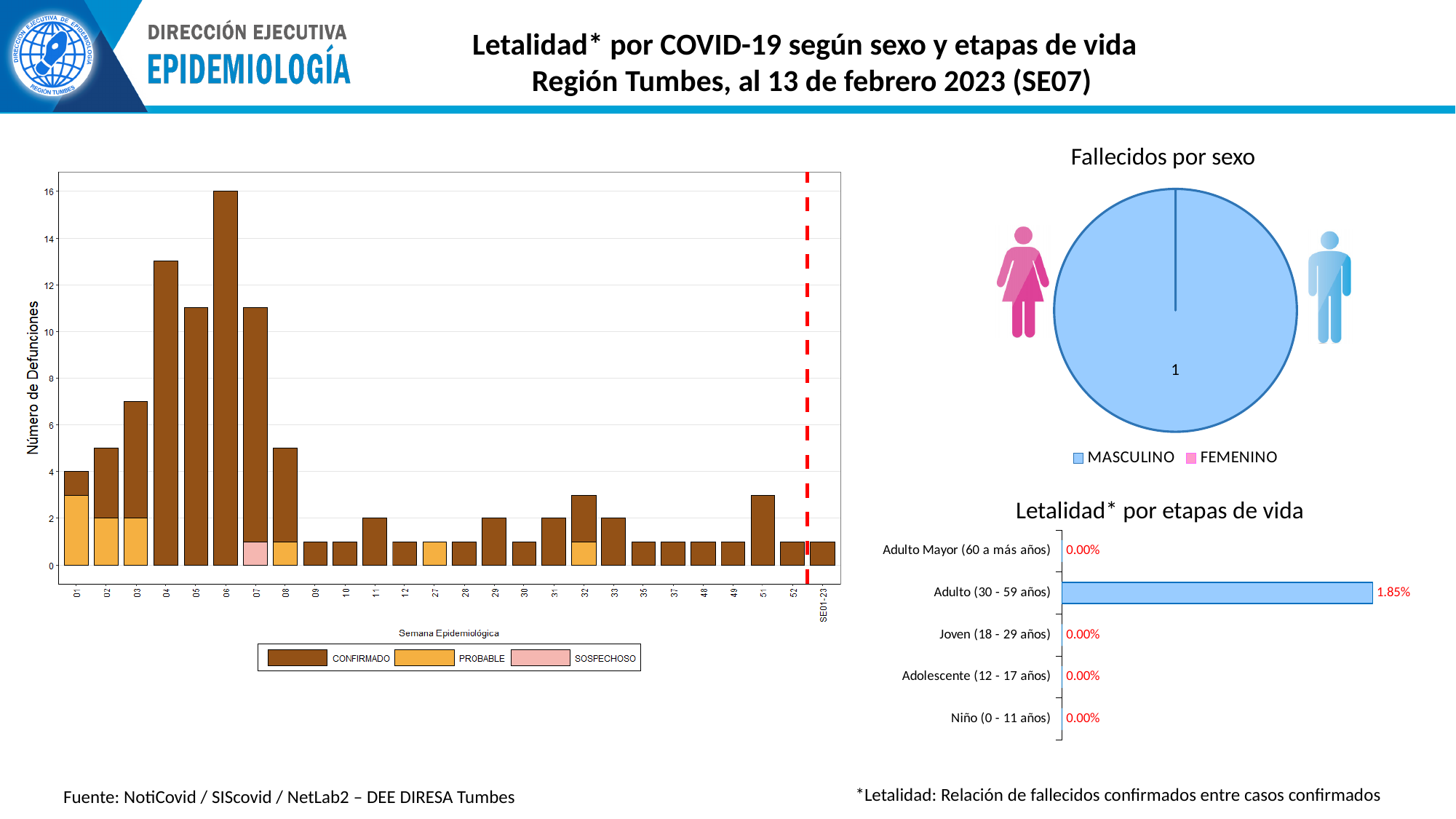
In the 'Letalidad* por etapas de vida' chart, which age group has the highest value? Adulto (30 - 59 años) How many series does the legend of the weekly 'Número de Defunciones' chart on the left list? 3 How many entries does the legend of the 'Fallecidos por sexo' pie chart list? 2 In the weekly 'Número de Defunciones' chart on the left, what is the total height of the bar for week 06? 16 In the 'Fallecidos por sexo' pie chart, which category does the only visible slice belong to? MASCULINO In the 'Letalidad* por etapas de vida' chart, what is the value for Adulto Mayor (60 a más años)? 0.00% In the 'Letalidad* por etapas de vida' chart, how many age groups are shown? 5 In the 'Fallecidos por sexo' pie chart, what value is printed on the slice? 1 In the weekly 'Número de Defunciones' chart on the left, which epidemiological week has the highest bar? 06 In the weekly 'Número de Defunciones' chart on the left, is the value for week 04 greater or less than 12? greater In the 'Letalidad* por etapas de vida' chart, what is the difference between the values for Adulto (30 - 59 años) and Joven (18 - 29 años)? 1.85% In the 'Letalidad* por etapas de vida' chart, what is the value for Adulto (30 - 59 años)? 1.85%